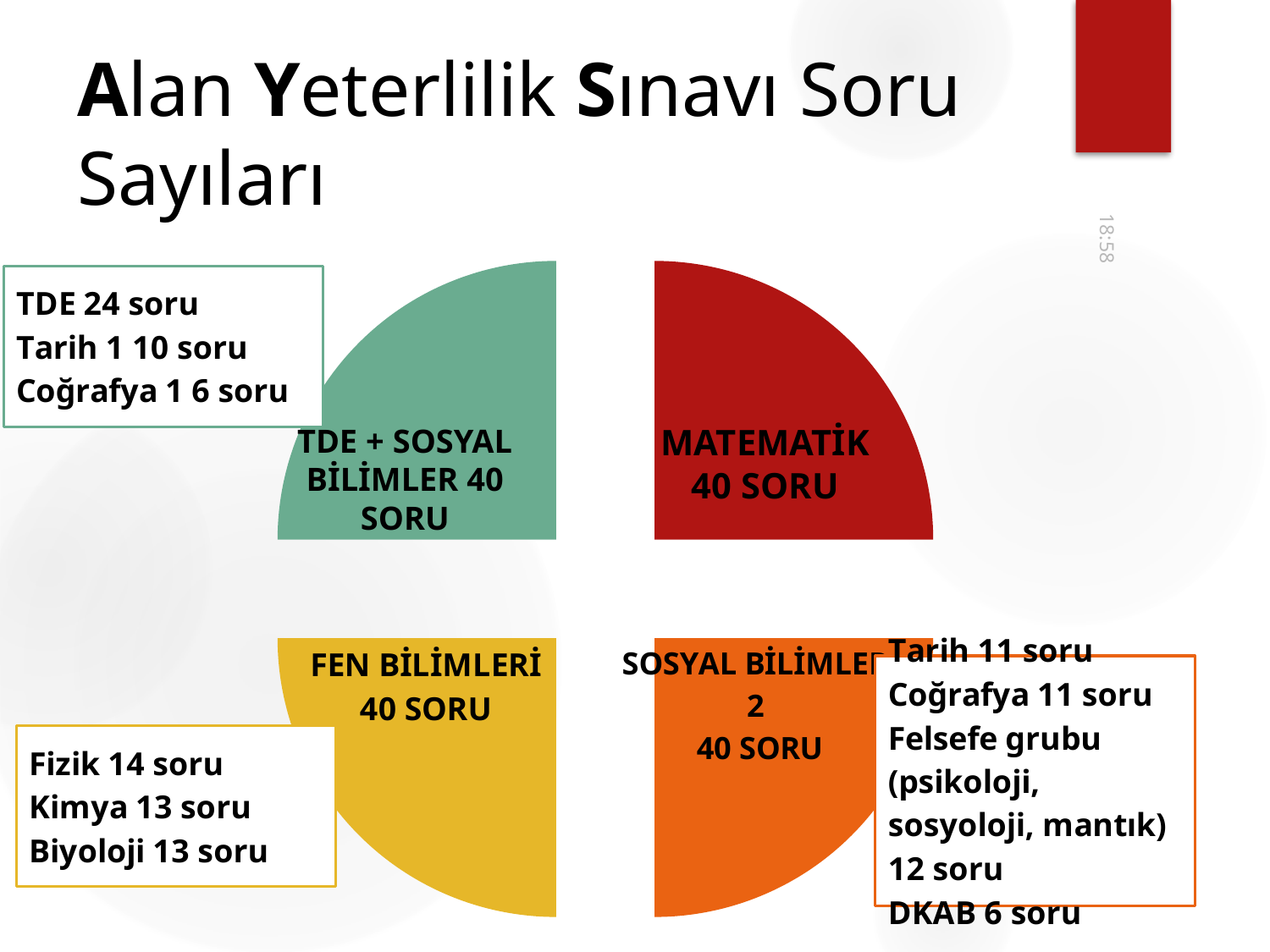
How many sections (slices) does the chart have? 4 Within the FEN BİLİMLERİ breakdown, which subject has the most questions? Fizik Within the TDE + SOSYAL BİLİMLER breakdown, which subject has the fewest questions? Coğrafya 1 How many questions does the MATEMATİK section of the chart contain? 40 SORU How many questions does the FEN BİLİMLERİ section contain? 40 SORU Which colour is used for the MATEMATİK section of the chart? red What is the total number of questions across all four sections of the chart? 160 What share of the total questions does the MATEMATİK section represent? 25% What is the difference between the number of Fizik questions and Kimya questions? 1 According to the box next to FEN BİLİMLERİ, how many questions are there for Fizik? 14 soru How many questions does the TDE + SOSYAL BİLİMLER section contain? 40 SORU What kind of chart is shown on the slide? pie chart